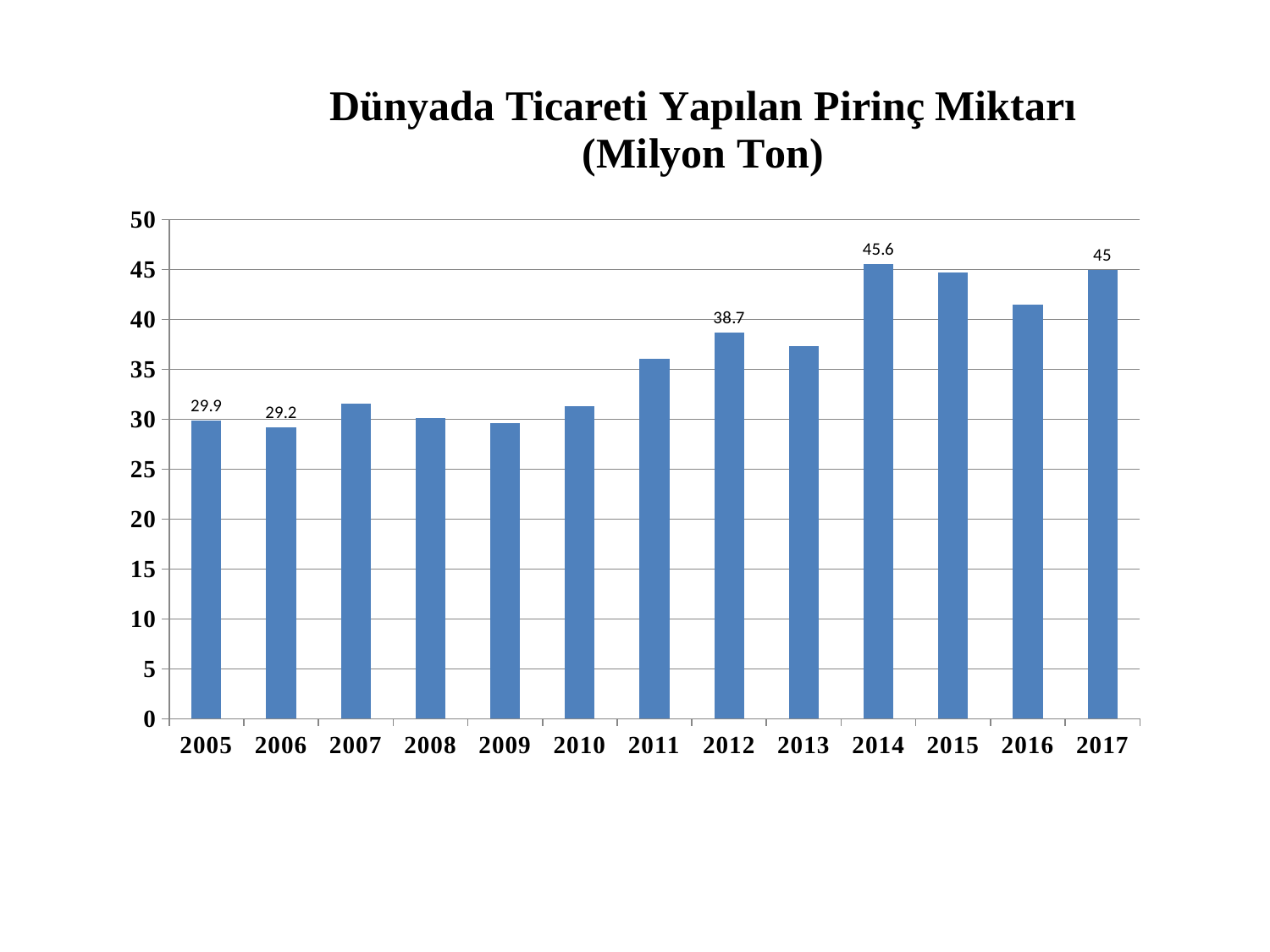
What kind of chart is shown on the slide? bar chart Is the value for 2011 greater or less than 35? greater What is the value for 2005? 29.9 Which is larger, the value for 2005 or the value for 2006? 2005 What is the value for 2014? 45.6 Do the values generally rise or fall from 2005 to 2017? rise How many years are shown on the x axis? 13 Which year has the highest value? 2014 What is the difference between the values for 2014 and 2005? 15.7 What is the value for 2012? 38.7 What is the value for 2017? 45 Is the value for 2013 greater or less than 40? less